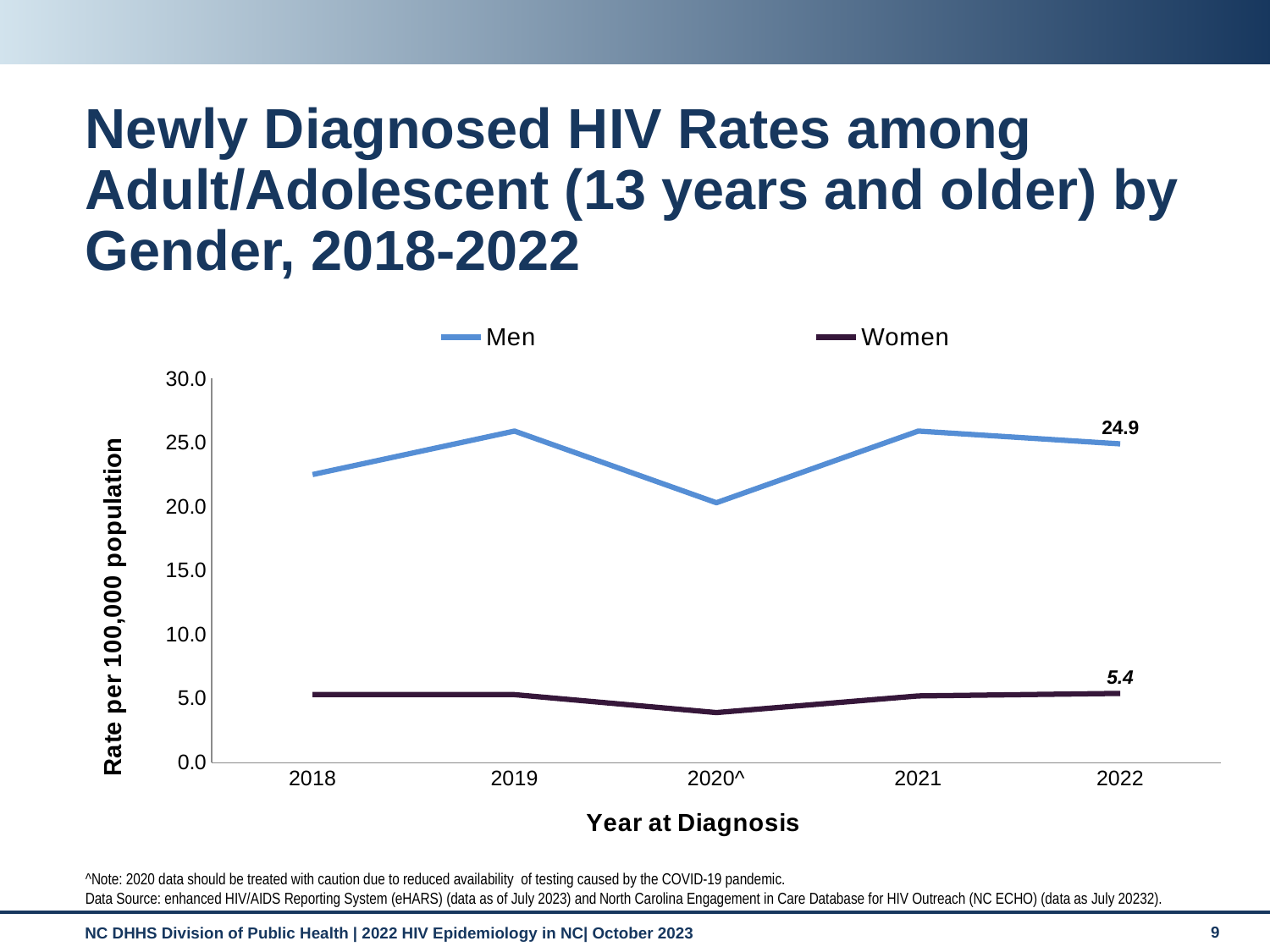
Is the value for Men in 2020^ greater or less than 25.0? less In which year is the rate for Men at its lowest? 2020^ In 2022, which series has the higher rate, Men or Women? Men How many years are shown on the x axis? 5 What kind of chart is shown on the slide? Line chart Does the rate for Men rise or fall from 2019 to 2020^? Fall Is the value for Women in 2020^ greater or less than 5.0? less What is the newly diagnosed HIV rate for Women in 2022? 5.4 What is the newly diagnosed HIV rate for Men in 2022? 24.9 What is the difference between the Men and Women rates in 2022? 19.5 Is the value for Men in 2018 greater or less than 20.0? greater How many series does the legend list? 2